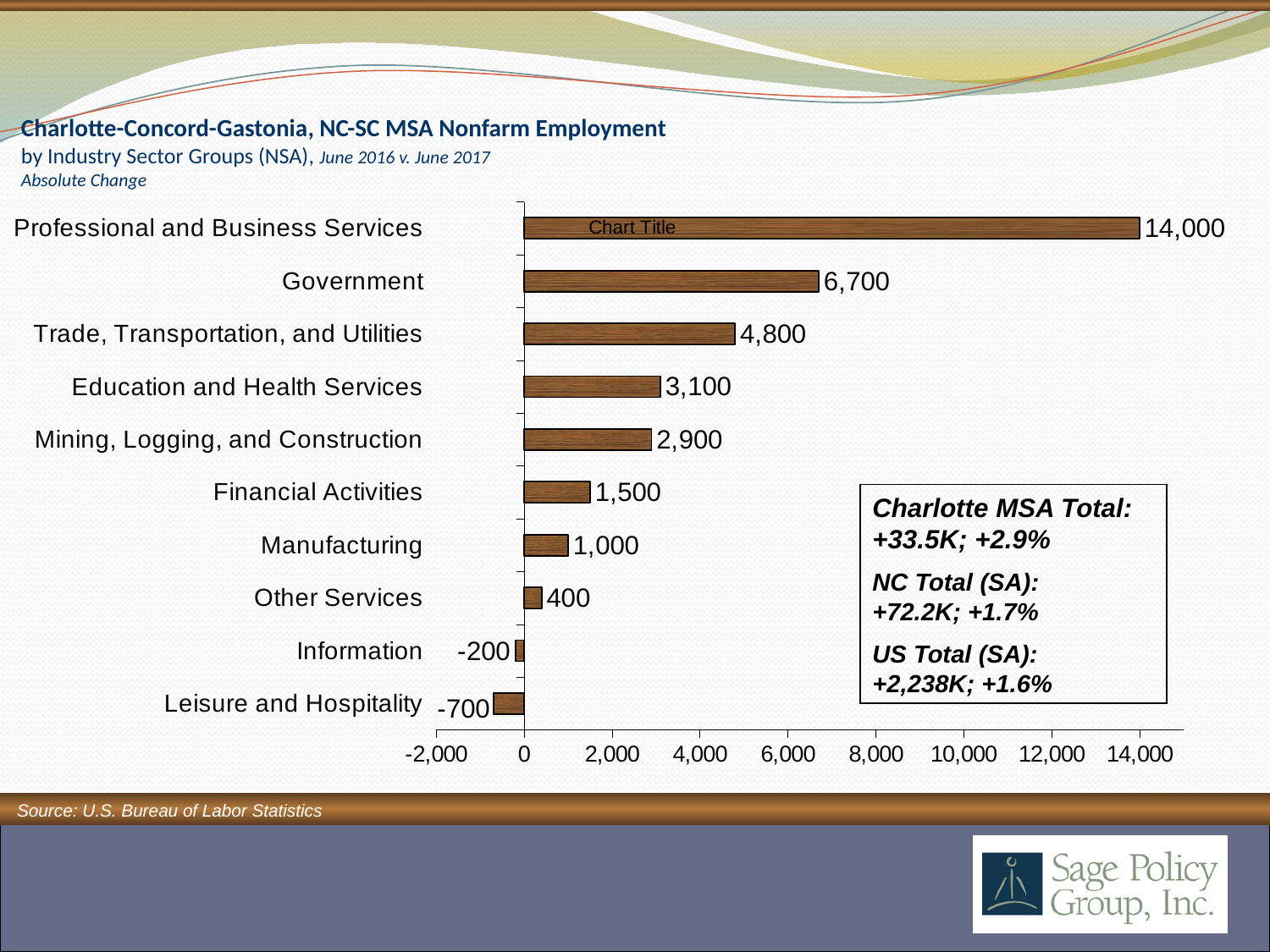
What kind of chart is shown on the slide? bar chart What is the value shown for Mining, Logging, and Construction? 2,900 Which industry sector group has the highest absolute change? Professional and Business Services According to the text box on the chart, what is the Charlotte MSA total change? +33.5K; +2.9% Which is larger, the value for Financial Activities or the value for Manufacturing? Financial Activities Which industry sector group has the lowest absolute change? Leisure and Hospitality What is the difference between the values for Professional and Business Services and Government? 7,300 Is the value for Education and Health Services greater or less than 4,000? less What is the absolute change in nonfarm employment for Government? 6,700 What is the difference between the values for Trade, Transportation, and Utilities and Education and Health Services? 1,700 What is the value shown for Leisure and Hospitality? -700 How many industry sector groups are shown in the chart? 10